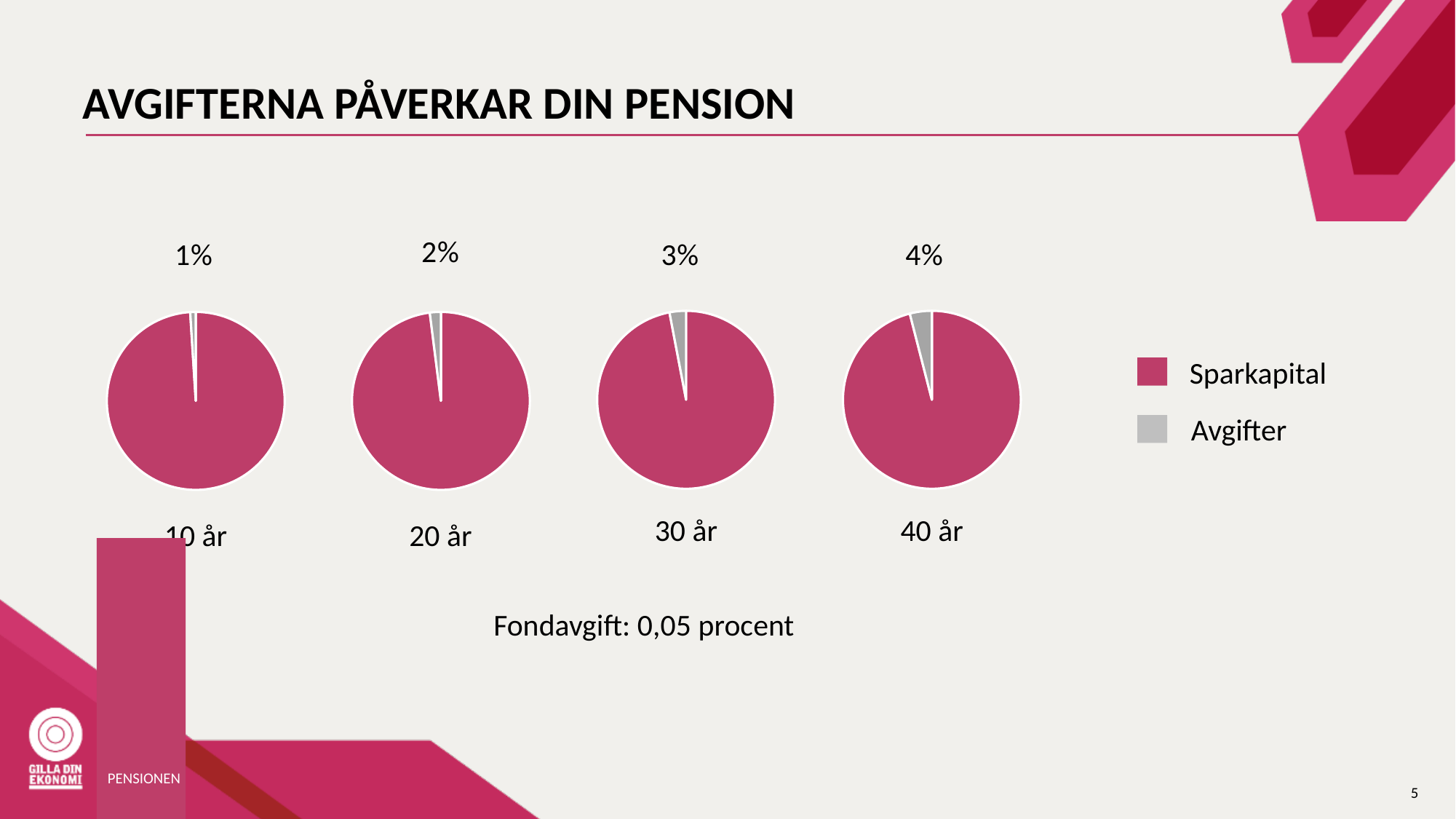
What percentage is printed above the 10 år pie chart? 1% Which colour represents Avgifter in the legend? Grey Which pie chart has the smallest Avgifter slice? 10 år How many pie charts are shown on the slide? 4 Which pie chart has the largest Avgifter slice? 40 år What percentage is printed above the 30 år pie chart? 3% What kind of charts are shown on the slide? Pie charts How many series does the legend list? 2 Is the Avgifter slice larger in the 30 år pie chart or the 10 år pie chart? 30 år What share of the 40 år pie chart is Avgifter? 4% What percentage is printed above the 20 år pie chart? 2% Does the Avgifter share rise or fall as the number of years increases from 10 år to 40 år? Rises